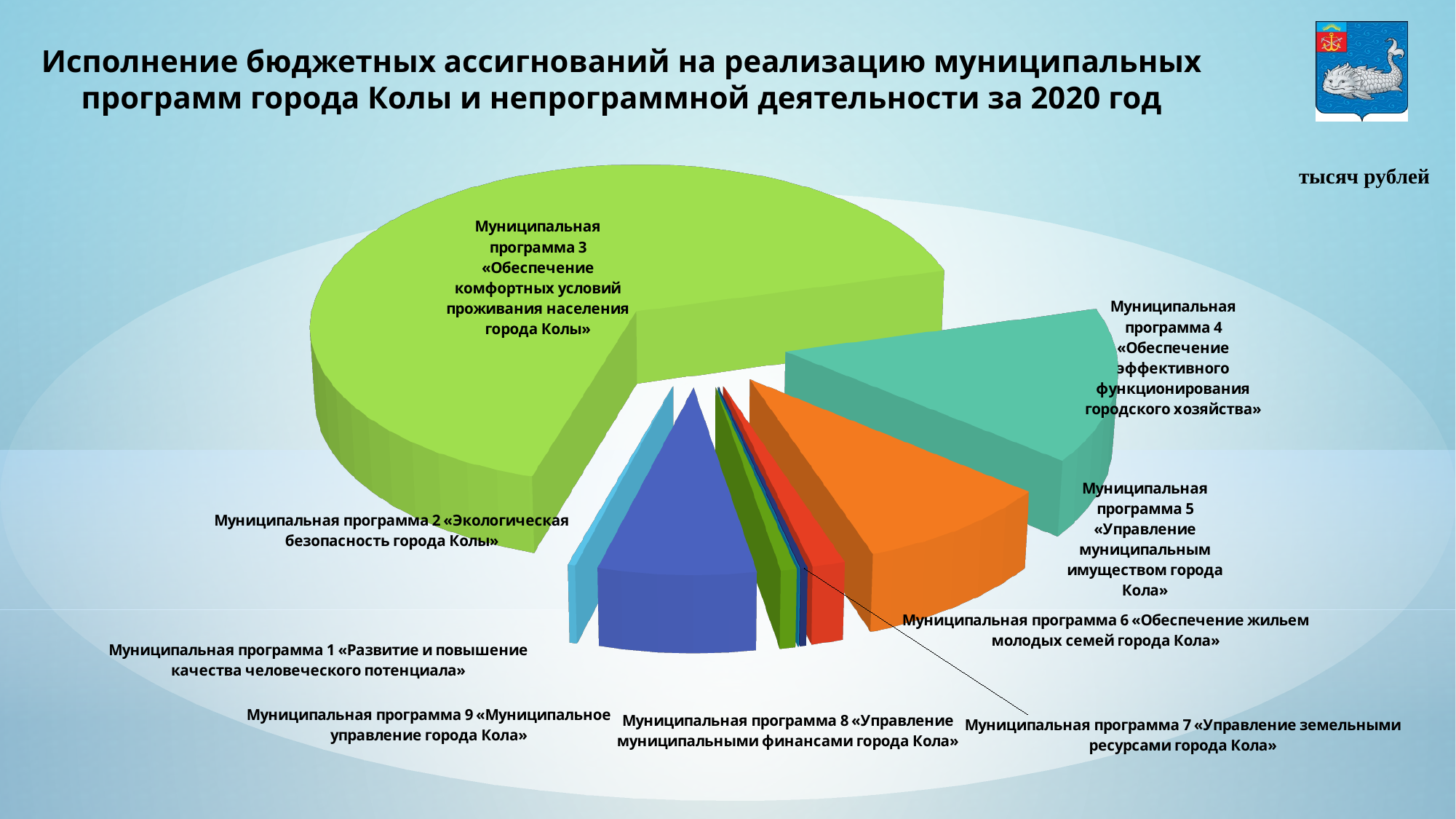
What colour is the slice for Муниципальная программа 3? green How many slices (municipal programs) does the pie chart show? 9 Which slice is larger: Муниципальная программа 3 or Муниципальная программа 4? Муниципальная программа 3 Which slice is larger: Муниципальная программа 4 or Муниципальная программа 1? Муниципальная программа 4 Which municipal program has the largest slice of the pie chart? Муниципальная программа 3 «Обеспечение комфортных условий проживания населения города Колы» Which slice is larger: Муниципальная программа 9 or Муниципальная программа 8? Муниципальная программа 9 In what units are the values of the chart expressed, according to the note on the slide? тысяч рублей What kind of chart is shown on the slide? pie chart